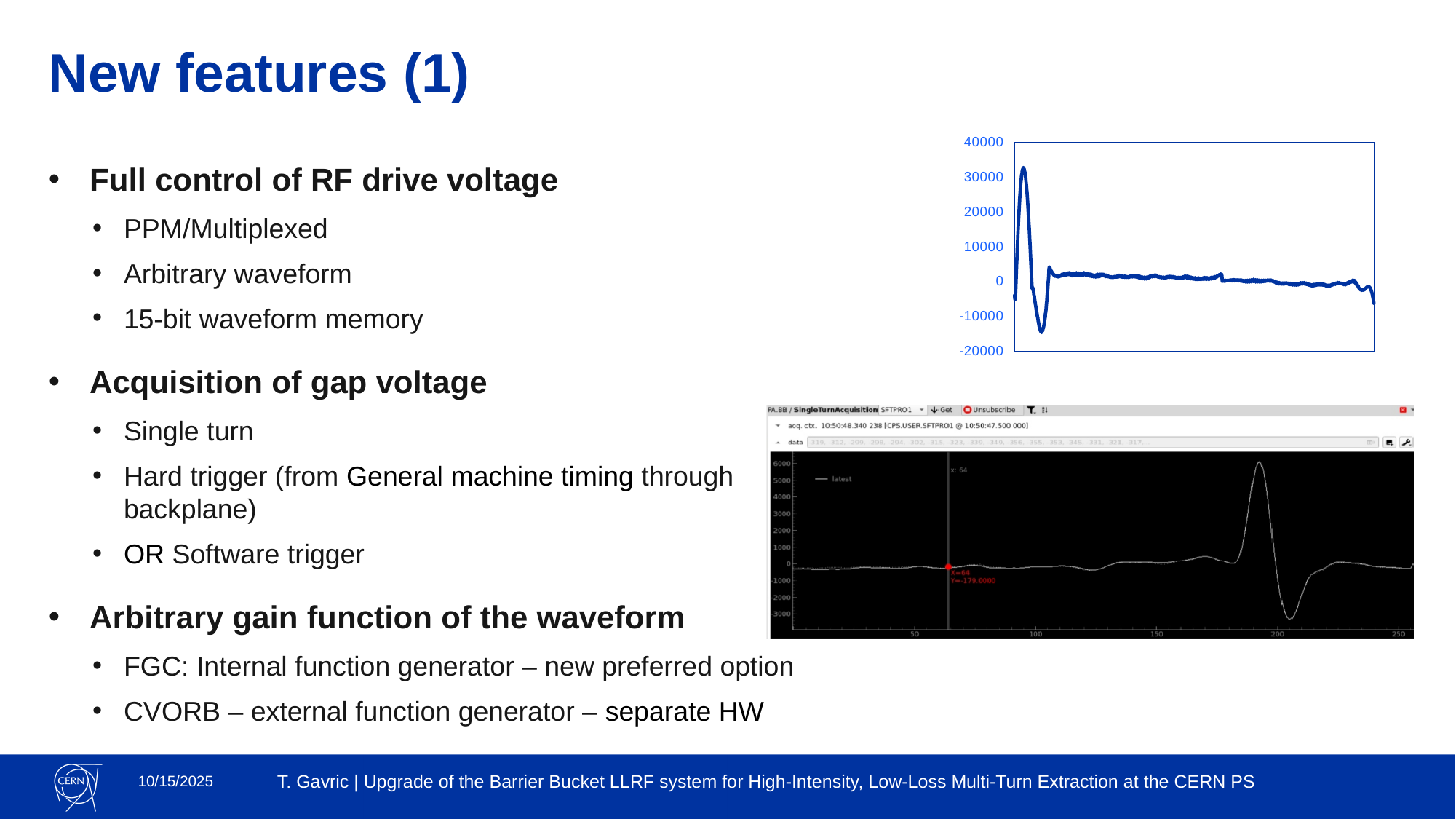
In the bottom-right acquisition chart, what is the name of the series in the legend? latest In the bottom-right acquisition chart, how many series does the legend list? 1 In the top-right chart, is the highest value of the line greater or less than 20000? greater In the bottom-right acquisition chart, is the peak value of the line greater or less than 5000? greater In the top-right chart, is the lowest value of the line greater or less than -10000? less In the top-right chart, what is the lowest value labelled on the vertical axis? -20000 In the bottom-right acquisition chart, what Y value is shown at the cursor position X=64? -179.0000 What kind of chart is shown in the bottom-right acquisition screenshot? line chart In the top-right chart, what is the highest value labelled on the vertical axis? 40000 What kind of chart is the top-right chart on the slide? line chart